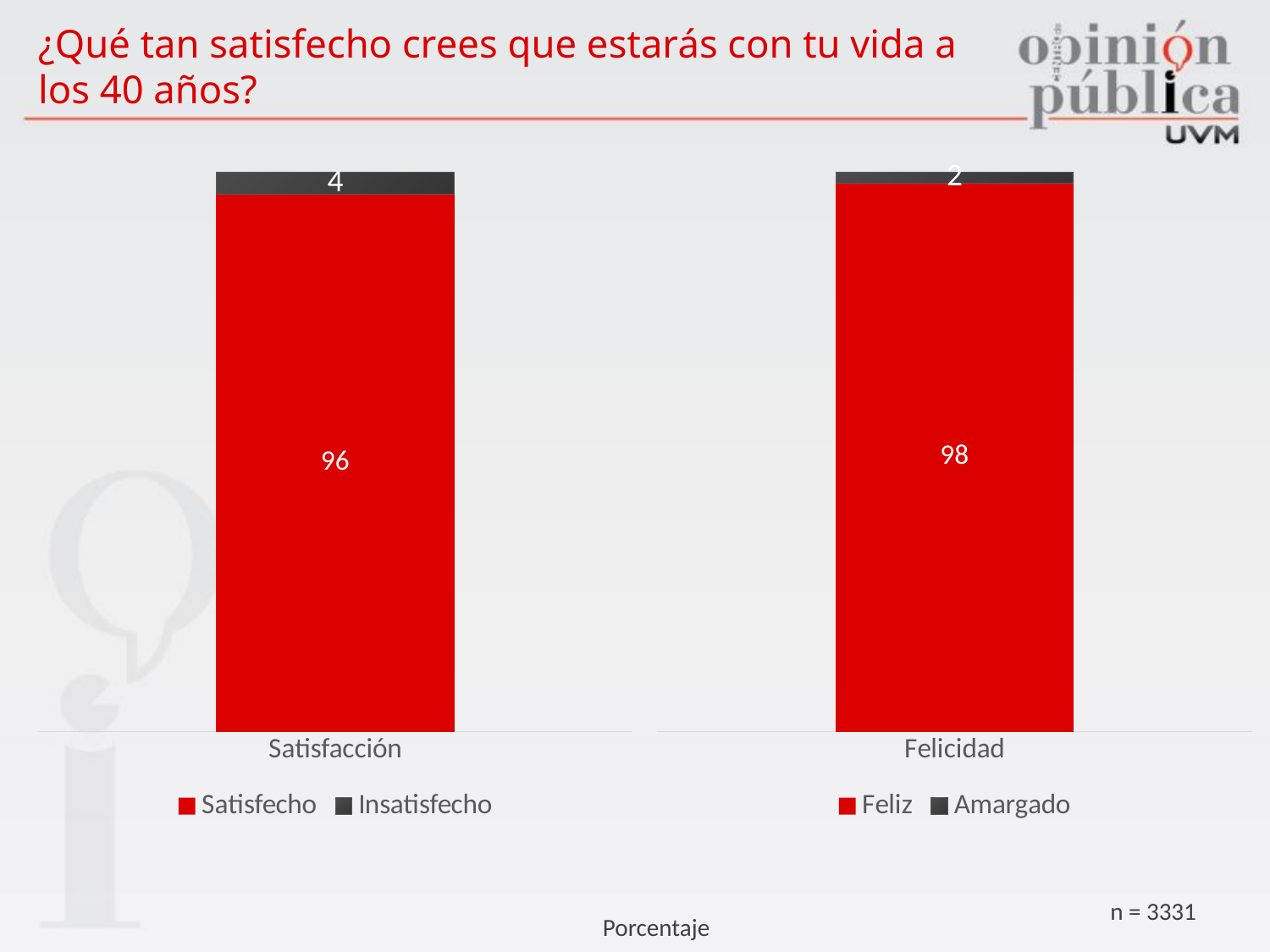
In the right chart (Felicidad), what is the difference between the Feliz and Amargado values? 96 What is the sample size (n) shown on the slide? n = 3331 In the left chart (Satisfacción), what is the value for Satisfecho? 96 In the right chart (Felicidad), what is the value for Feliz? 98 In the left chart (Satisfacción), which series has the larger value, Satisfecho or Insatisfecho? Satisfecho In the right chart (Felicidad), what is the value for Amargado? 2 In the left chart (Satisfacción), what is the value for Insatisfecho? 4 What kind of chart is used on this slide? Stacked bar chart How many series does the legend of the left chart (Satisfacción) list? 2 In the right chart (Felicidad), what is the total of the stacked bar? 100 In the right chart (Felicidad), which series has the smallest value? Amargado In the left chart (Satisfacción), what is the difference between the Satisfecho and Insatisfecho values? 92